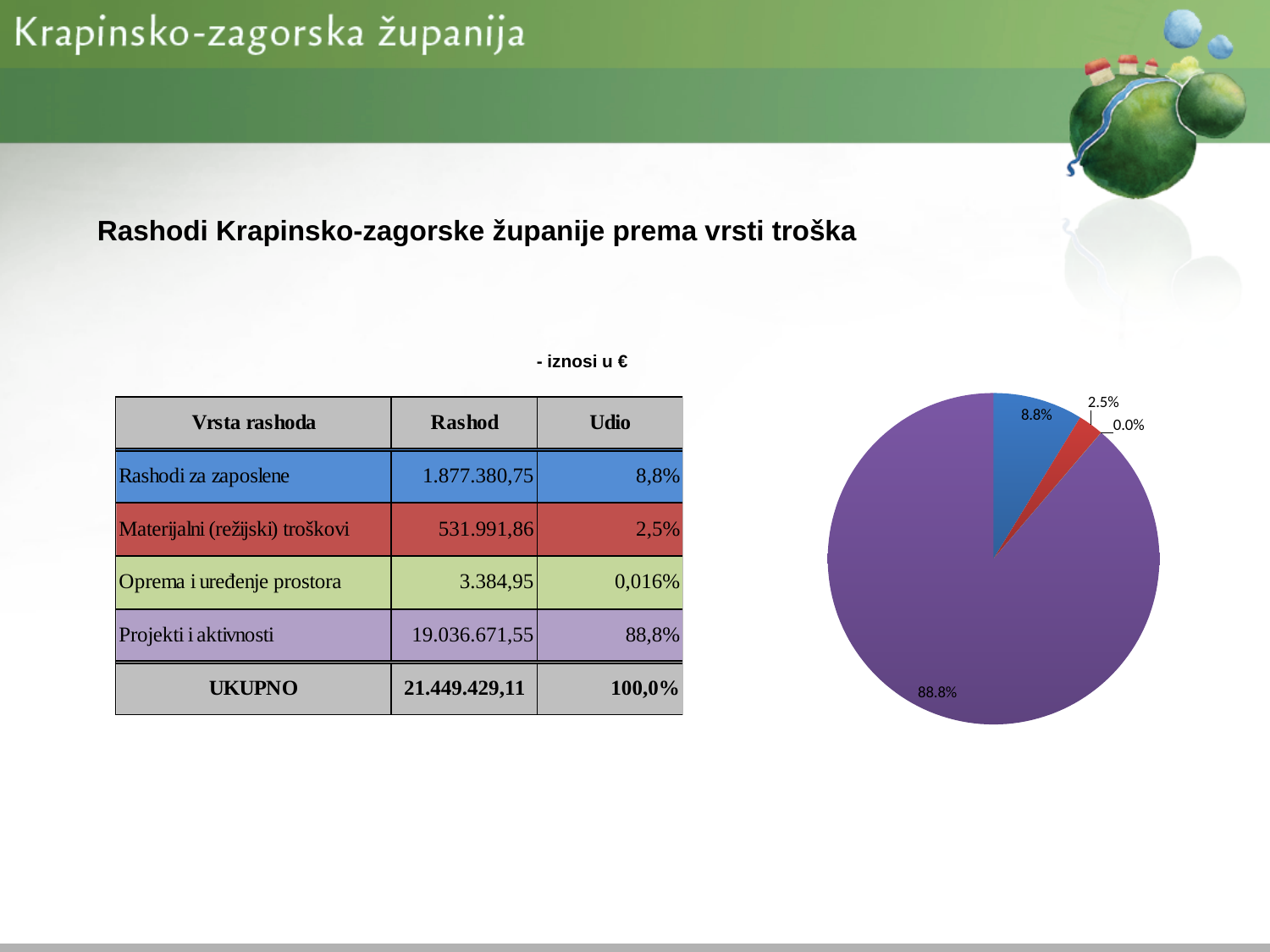
According to the table colours, which expense category does the purple slice of the pie chart represent? Projekti i aktivnosti Does the pie chart display a legend? No Which colour slice is the largest in the pie chart? purple What is the combined share of the blue and red slices in the pie chart? 11.3% What kind of chart is shown on the right of the slide? pie chart How many slices does the pie chart have? 4 What percentage is shown on the largest slice of the pie chart? 88.8% What percentage label is shown on the red slice of the pie chart? 2.5% What percentage label is shown on the blue slice of the pie chart? 8.8% Which slice is larger in the pie chart, the blue one or the red one? the blue one What is the difference between the 88.8% slice and the 8.8% slice in the pie chart? 80.0% What percentage label is shown for the smallest slice of the pie chart? 0.0%